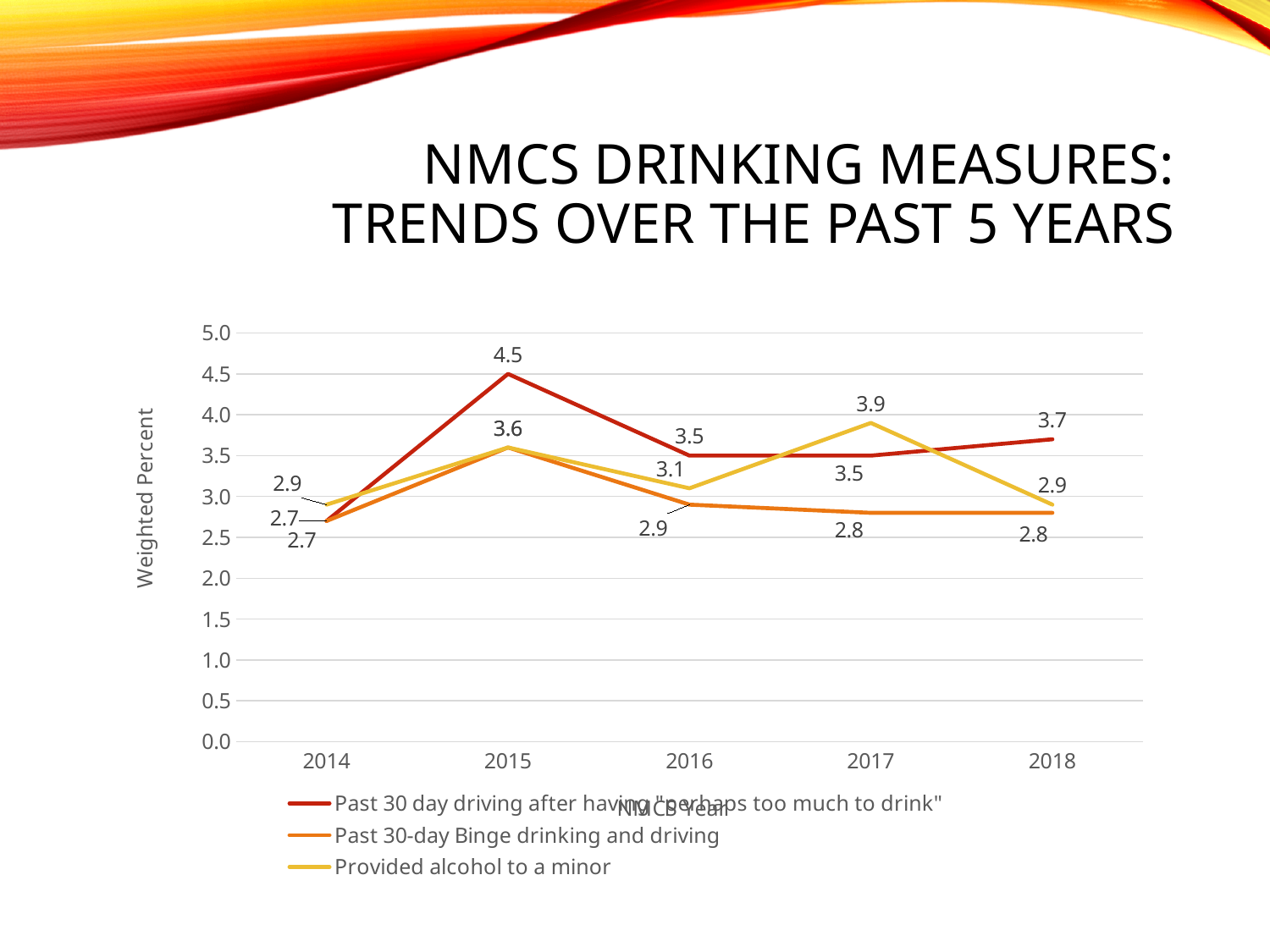
What is the value for "Provided alcohol to a minor" in 2017? 3.9 How many series does the legend list? 3 What is the label on the y axis? Weighted Percent What is the difference between the 2015 and 2014 values for "Past 30 day driving after having 'perhaps too much to drink'"? 1.8 In which year is "Past 30 day driving after having 'perhaps too much to drink'" highest? 2015 How many years are plotted along the x axis? 5 What is the value for "Past 30 day driving after having 'perhaps too much to drink'" in 2015? 4.5 Does "Provided alcohol to a minor" rise or fall from 2017 to 2018? fall In 2018, which is larger: "Past 30 day driving after having 'perhaps too much to drink'" or "Provided alcohol to a minor"? Past 30 day driving after having "perhaps too much to drink" In which year is "Past 30 day driving after having 'perhaps too much to drink'" lowest? 2014 What is the value for "Past 30-day Binge drinking and driving" in 2018? 2.8 What kind of chart is shown on the slide? line chart